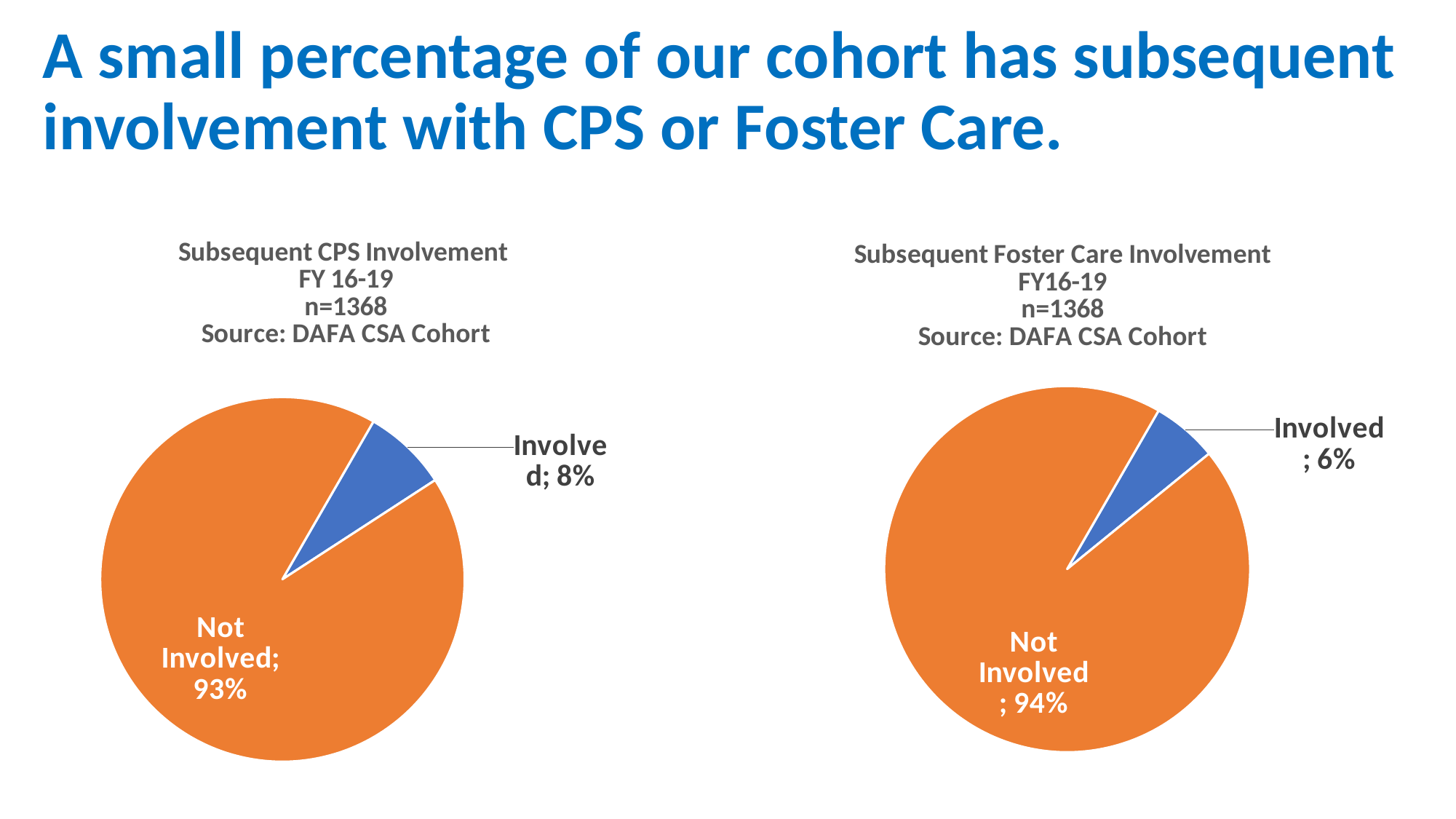
In the Subsequent CPS Involvement chart, what percentage of the cohort is labelled Not Involved? 93% In the Subsequent Foster Care Involvement chart, what percentage of the cohort is labelled Not Involved? 94% What kind of chart is the Subsequent CPS Involvement chart? Pie chart In the Subsequent Foster Care Involvement chart, which slice is the largest? Not Involved What is the difference in percentage points between the Involved slices of the Subsequent CPS Involvement chart and the Subsequent Foster Care Involvement chart? 2 percentage points How many slices does the Subsequent Foster Care Involvement pie chart have? 2 Is the Involved share larger in the Subsequent CPS Involvement chart or the Subsequent Foster Care Involvement chart? Subsequent CPS Involvement In the Subsequent Foster Care Involvement chart, what percentage of the cohort is labelled Involved? 6% What is the sample size (n) shown in the title of the Subsequent CPS Involvement chart? n=1368 In the Subsequent CPS Involvement chart, which slice is the smallest? Involved What colour is the Involved slice in the Subsequent Foster Care Involvement chart? Blue In the Subsequent CPS Involvement chart, what percentage of the cohort is labelled Involved? 8%